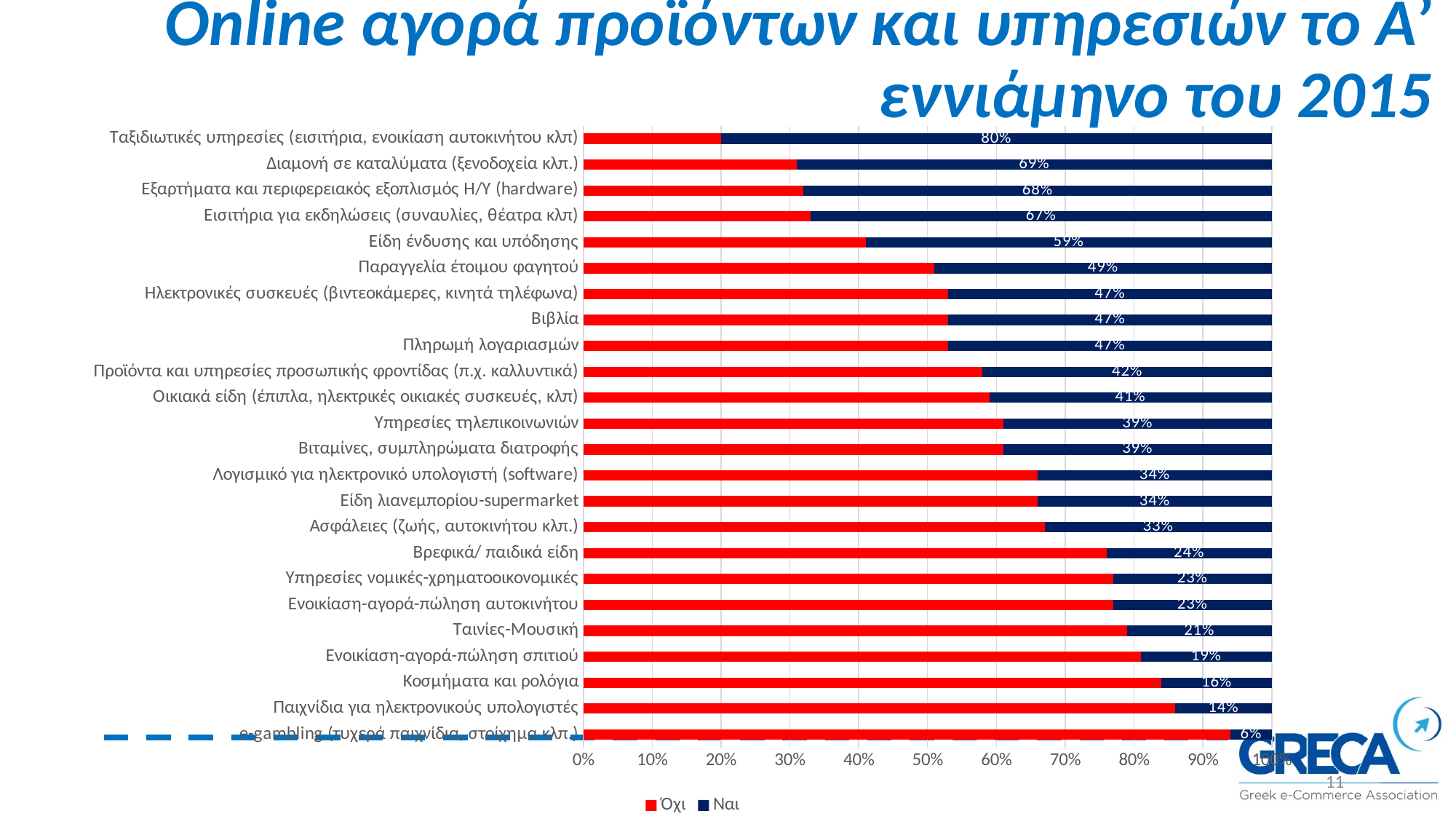
Is the Όχι value for Ταξιδιωτικές υπηρεσίες (εισιτήρια, ενοικίαση αυτοκινήτου κλπ) greater or less than 30%? less What is the difference between the Ναι value for Διαμονή σε καταλύματα (ξενοδοχεία κλπ.) and the Ναι value for Ταινίες-Μουσική? 48% How many series does the legend list? 2 What is the Ναι value for Κοσμήματα και ρολόγια? 16% What are the two series named in the legend? Όχι and Ναι What is the Ναι value for Ταξιδιωτικές υπηρεσίες (εισιτήρια, ενοικίαση αυτοκινήτου κλπ)? 80% How many categories are plotted on the chart? 24 Which category has the highest Ναι value? Ταξιδιωτικές υπηρεσίες (εισιτήρια, ενοικίαση αυτοκινήτου κλπ) What type of chart is shown on the slide? Stacked bar chart Which category has the lowest Ναι value? e-gambling (τυχερά παιχνίδια, στοίχημα κλπ.) What is the Ναι value for Βιβλία? 47% Which has a larger Ναι value: Είδη ένδυσης και υπόδησης or Παραγγελία έτοιμου φαγητού? Είδη ένδυσης και υπόδησης